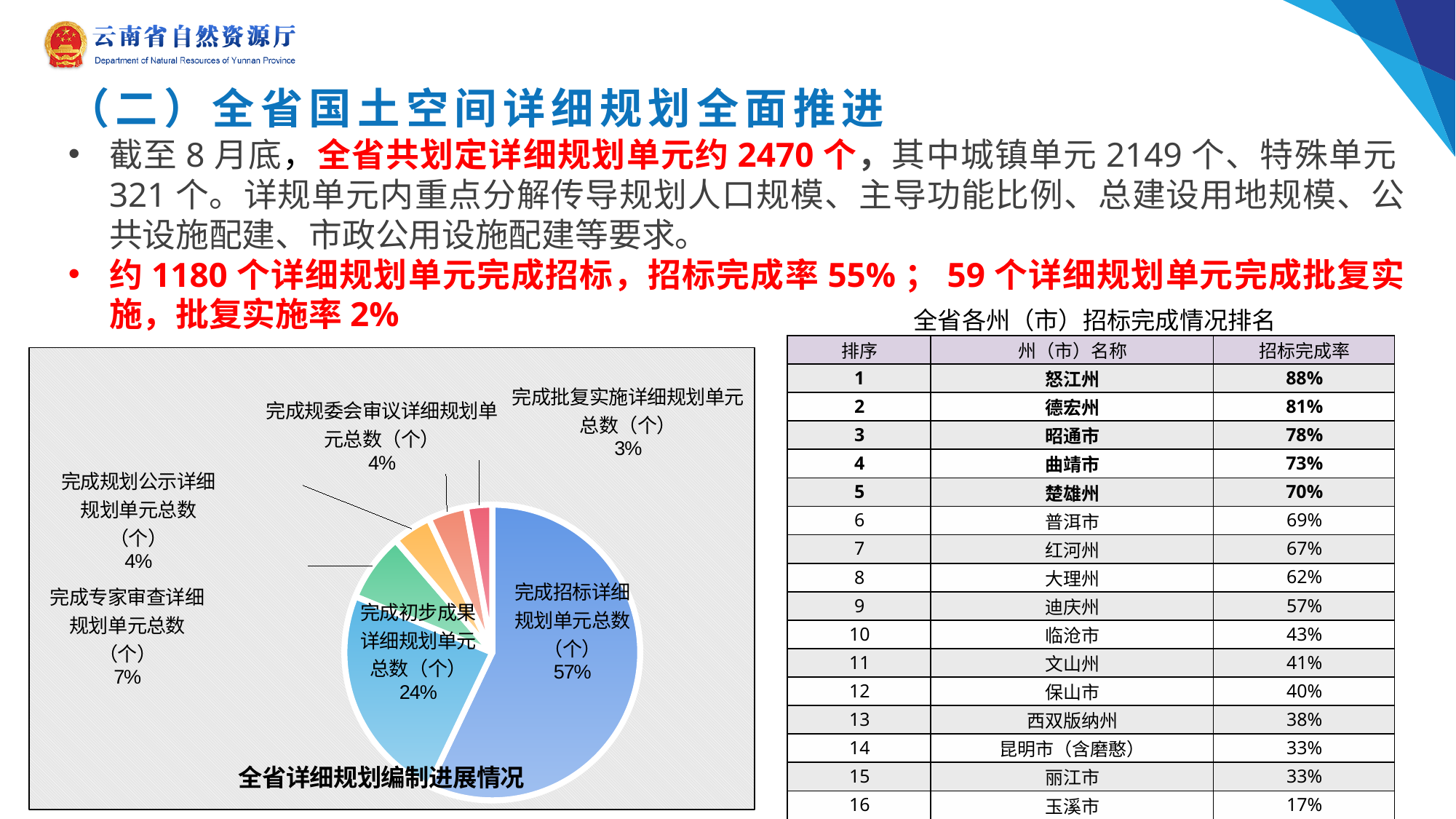
In the pie chart 全省详细规划编制进展情况, what share is labelled for 完成专家审查详细规划单元总数（个）? 7% In the pie chart 全省详细规划编制进展情况, what share is labelled for 完成初步成果详细规划单元总数（个）? 24% In the pie chart 全省详细规划编制进展情况, what is the difference in percentage points between 完成招标详细规划单元总数（个） and 完成初步成果详细规划单元总数（个）? 33 percentage points In the pie chart 全省详细规划编制进展情况, what share is labelled for 完成批复实施详细规划单元总数（个）? 3% What is the title printed below the pie chart on the slide? 全省详细规划编制进展情况 What kind of chart is shown on the slide under the title 全省详细规划编制进展情况? pie chart In the pie chart 全省详细规划编制进展情况, which slice is the smallest? 完成批复实施详细规划单元总数（个） In the pie chart 全省详细规划编制进展情况, what share is labelled for 完成规委会审议详细规划单元总数（个）? 4% In the pie chart 全省详细规划编制进展情况, which slice is the largest? 完成招标详细规划单元总数（个） In the pie chart 全省详细规划编制进展情况, what share is labelled for 完成招标详细规划单元总数（个）? 57% In the pie chart 全省详细规划编制进展情况, how many slices does the pie have? 6 In the pie chart 全省详细规划编制进展情况, which is larger: 完成专家审查详细规划单元总数（个） or 完成规划公示详细规划单元总数（个）? 完成专家审查详细规划单元总数（个）